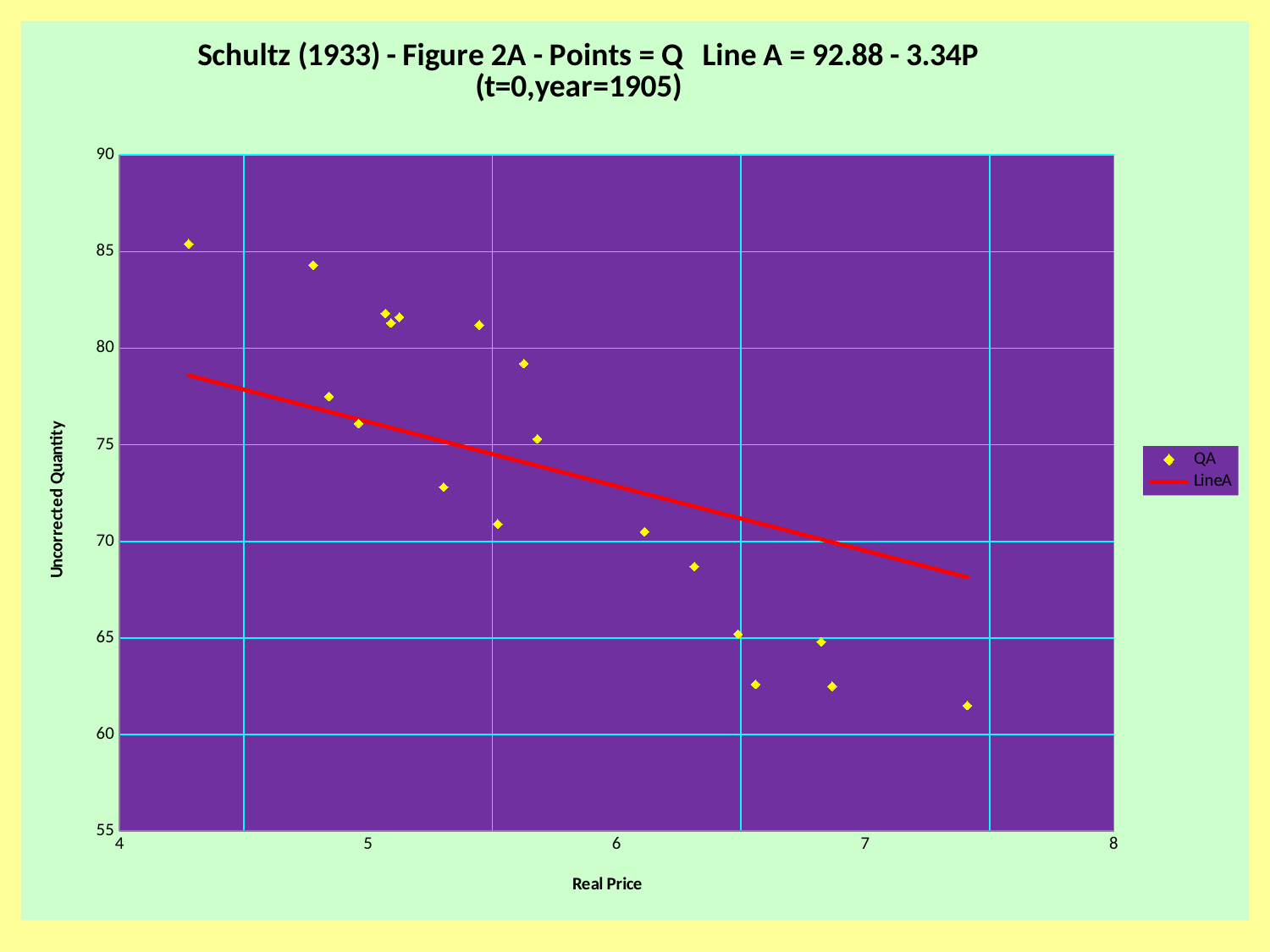
Is the Uncorrected Quantity of the QA point at a Real Price of about 7.4 greater or less than 65? less What is the title of the x axis? Real Price Is the value of LineA at a Real Price of 6 greater or less than 70? greater How many series does the legend list? 2 As Real Price increases along the x axis, do the QA points generally rise or fall? Fall Is the Uncorrected Quantity of the leftmost QA point (Real Price about 4.3) greater or less than 80? greater How many QA points have a Real Price greater than 7? 1 Which has the higher Uncorrected Quantity: the QA point at a Real Price of about 4.3 or the QA point at a Real Price of about 7.4? The point at about 4.3 What kind of chart is shown on the slide? Scatter chart What are the two entries in the legend? QA and LineA Does LineA slope upward or downward as Real Price increases? Downward